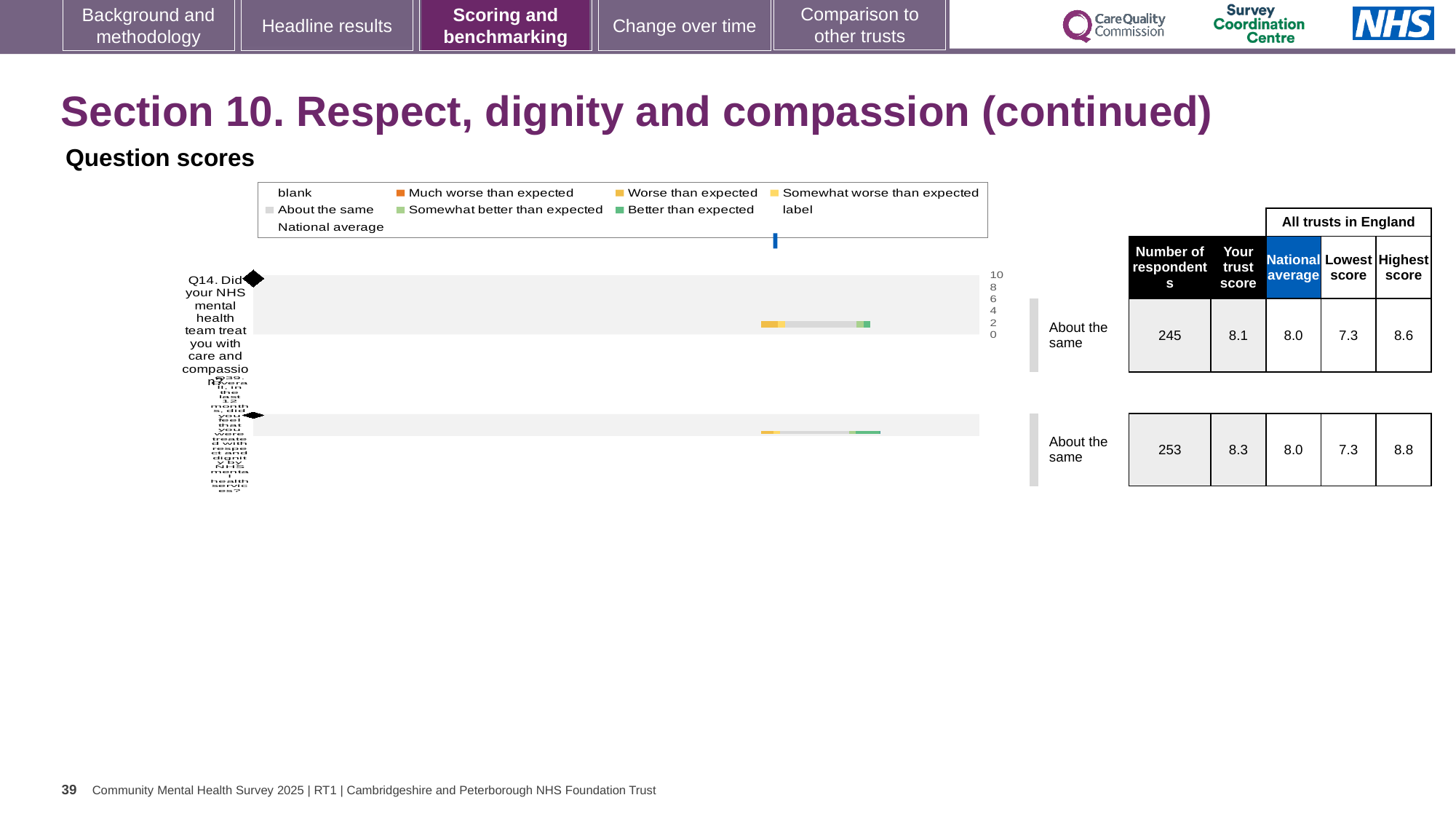
How many questions are plotted in the Question scores chart? 2 What colour represents 'Better than expected' in the chart legend? green Which question has the higher trust score, Q14 or Q39? Q39 What is 'Your trust score' for Q14 (Did your NHS mental health team treat you with care and compassion?)? 8.1 What is 'Your trust score' for Q39, the second question in the chart? 8.3 What is the national average score for Q14? 8.0 What is the difference between the highest score and the lowest score for Q14? 1.3 By how much does the trust score for Q39 exceed the national average for Q39? 0.3 What benchmark category is shown for both Q14 and Q39? About the same How many respondents answered Q14? 245 What kind of chart is shown under 'Question scores'? bar chart What is the highest score among all trusts in England for Q39? 8.8